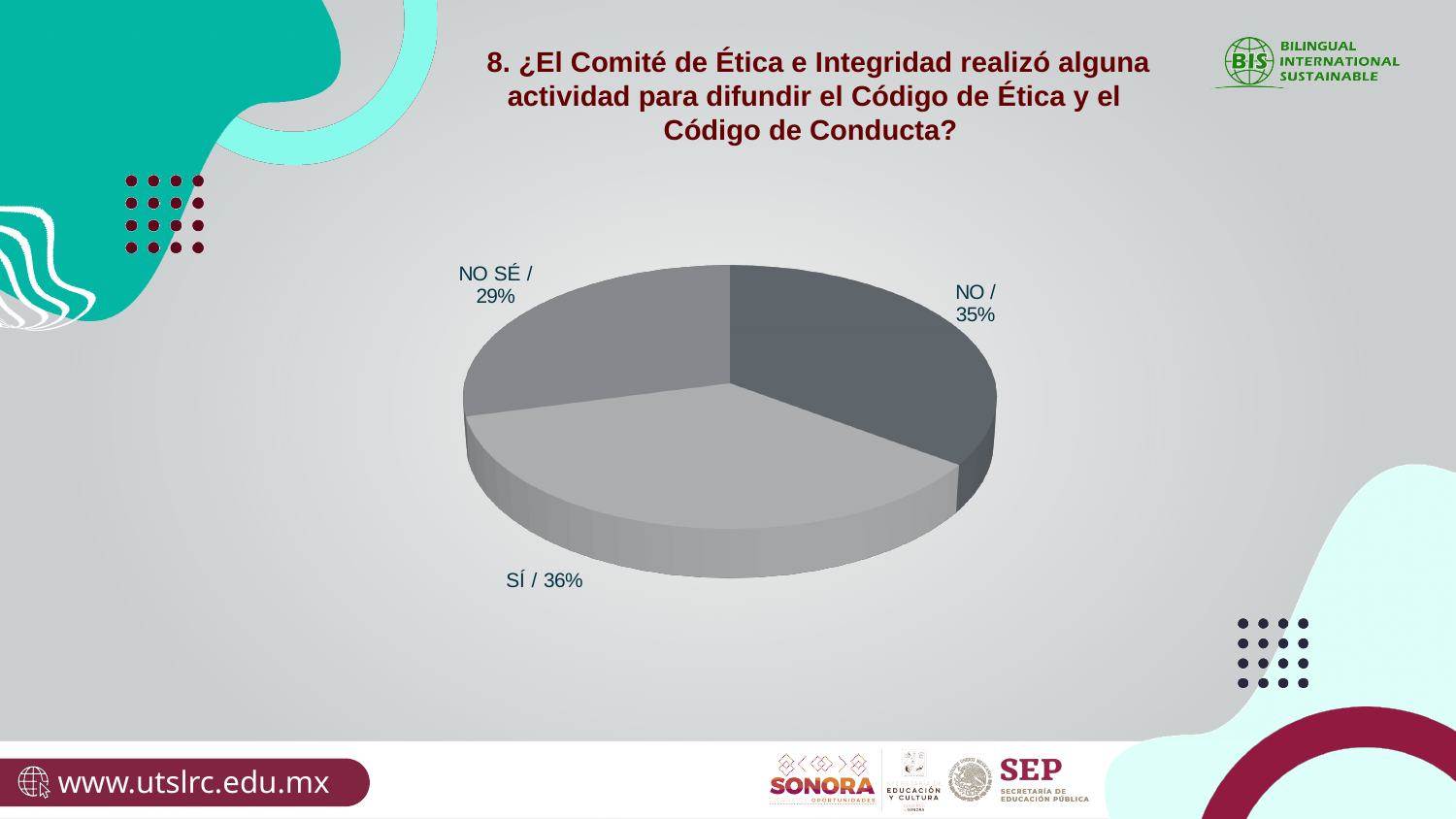
What percentage of respondents answered SÍ? 36% What is the number of the survey question shown as the chart title? 8 What percentage of respondents answered NO? 35% Which is larger, the NO slice or the NO SÉ slice? NO What kind of chart is shown on the slide? pie chart What percentage of respondents answered NO SÉ? 29% What is the difference in percentage points between the NO and NO SÉ slices? 6 Which is larger, the SÍ slice or the NO slice? SÍ What is the difference in percentage points between the SÍ and NO SÉ slices? 7 How many slices does the pie chart have? 3 Which response has the smallest share of the pie? NO SÉ Which response has the largest share of the pie? SÍ